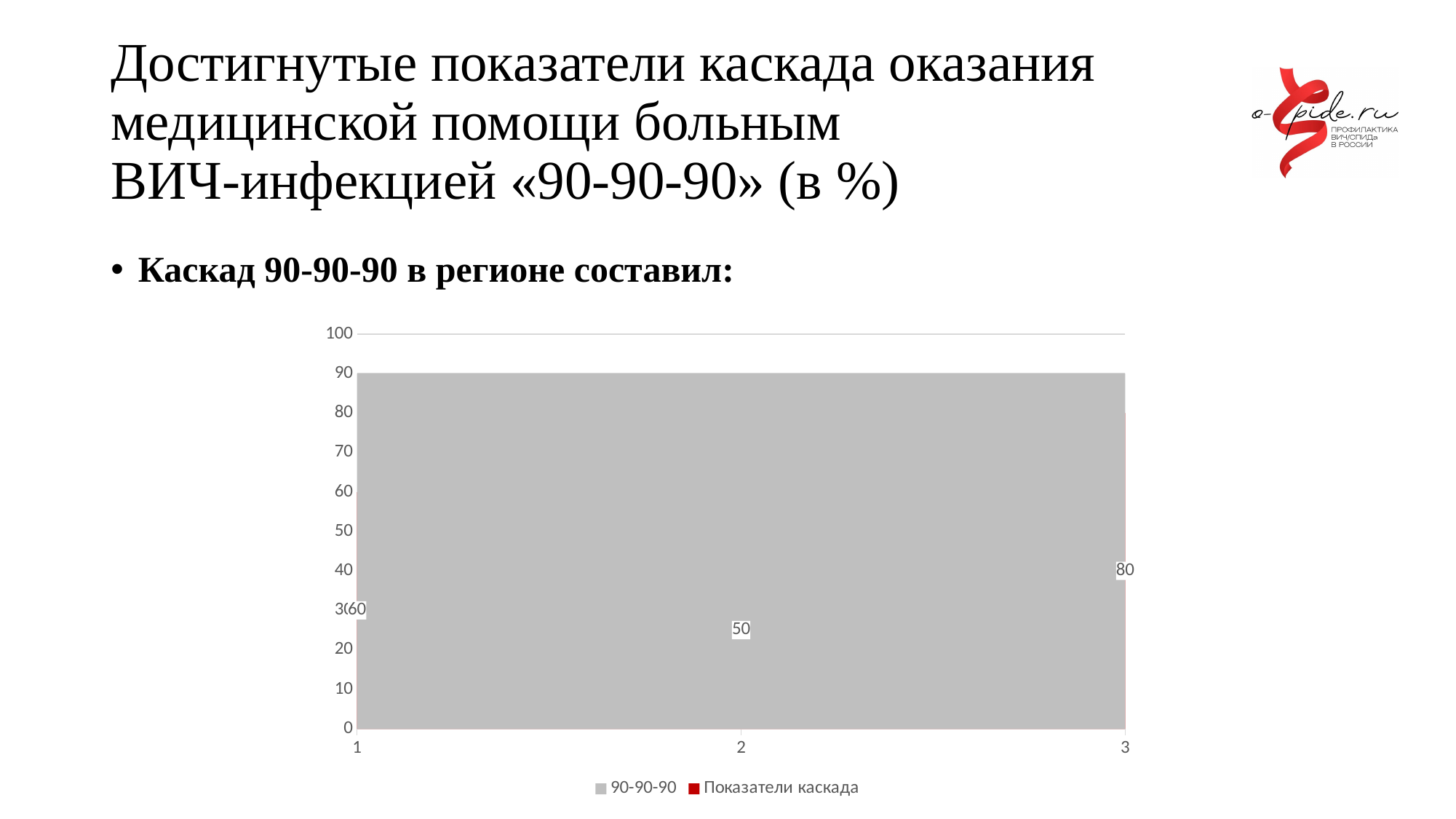
What is the difference between the Показатели каскада values at point 3 and point 2? 30 What is the value of the Показатели каскада series at point 2? 50 What is the value of the Показатели каскада series at point 1? 60 What is the value of the Показатели каскада series at point 3? 80 What kind of chart is shown on the slide? area chart Is the value of the Показатели каскада series at point 2 greater or less than 60? less Does the Показатели каскада series rise or fall from point 2 to point 3? rise At which point on the x axis does the Показатели каскада series reach its highest value? 3 Which is larger for the Показатели каскада series: the value at point 1 or at point 3? point 3 How many series does the legend list? 2 At which point on the x axis does the Показатели каскада series have its lowest value? 2 How many points are plotted along the x axis? 3